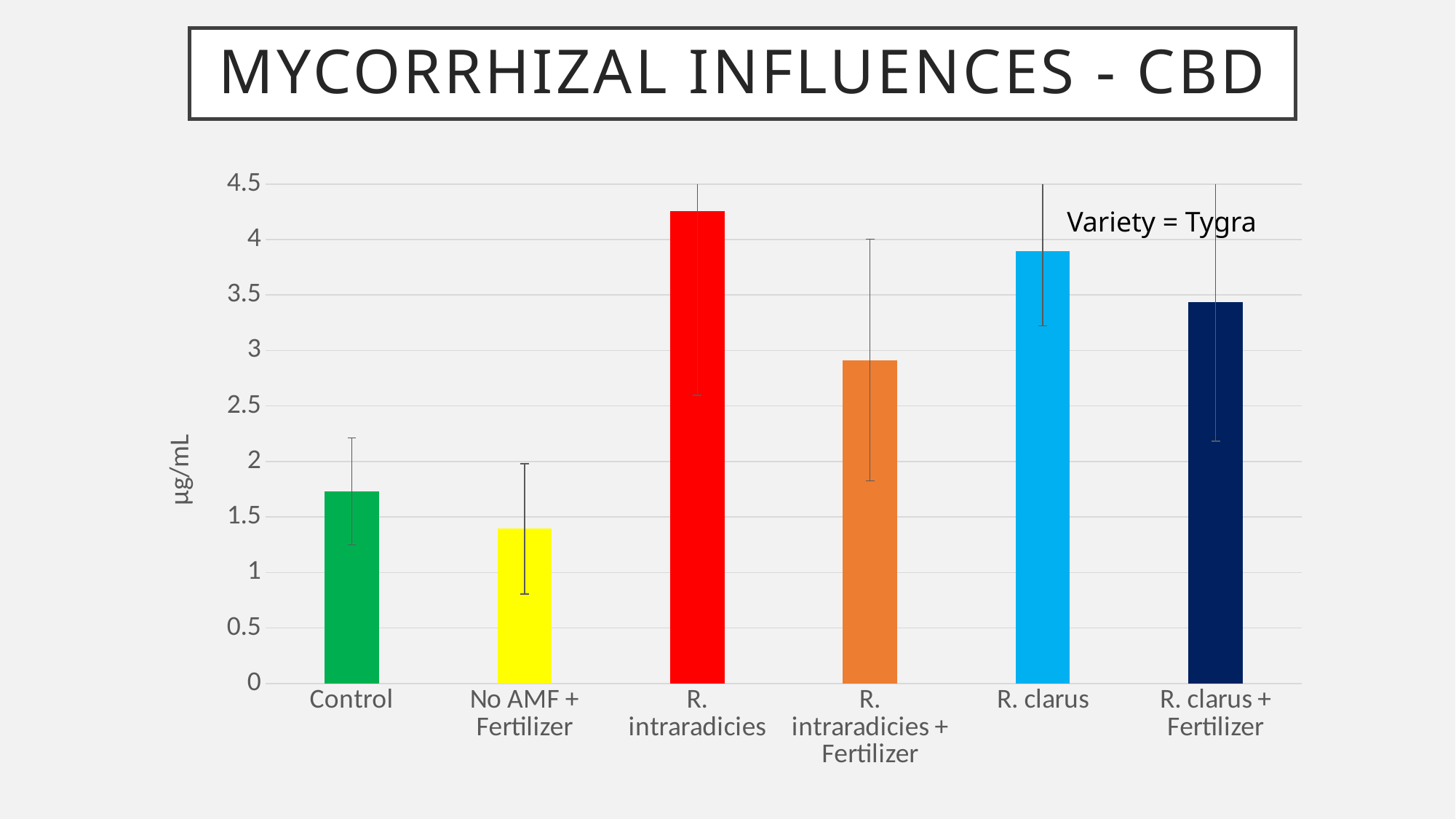
What unit is shown on the y axis label? µg/mL Which treatment has the lowest CBD value? No AMF + Fertilizer Is the value for R. clarus + Fertilizer greater or less than 3? greater Is the value for Control greater or less than 2? less Which has a higher value, R. intraradicies or R. clarus? R. intraradicies Which treatment has the highest CBD value? R. intraradicies What is the title of the slide? MYCORRHIZAL INFLUENCES - CBD Which has a higher value, Control or No AMF + Fertilizer? Control Is the value for R. intraradicies + Fertilizer greater or less than 2.5? greater How many treatment categories are plotted on the x axis? 6 What kind of chart is shown on the slide? Bar chart